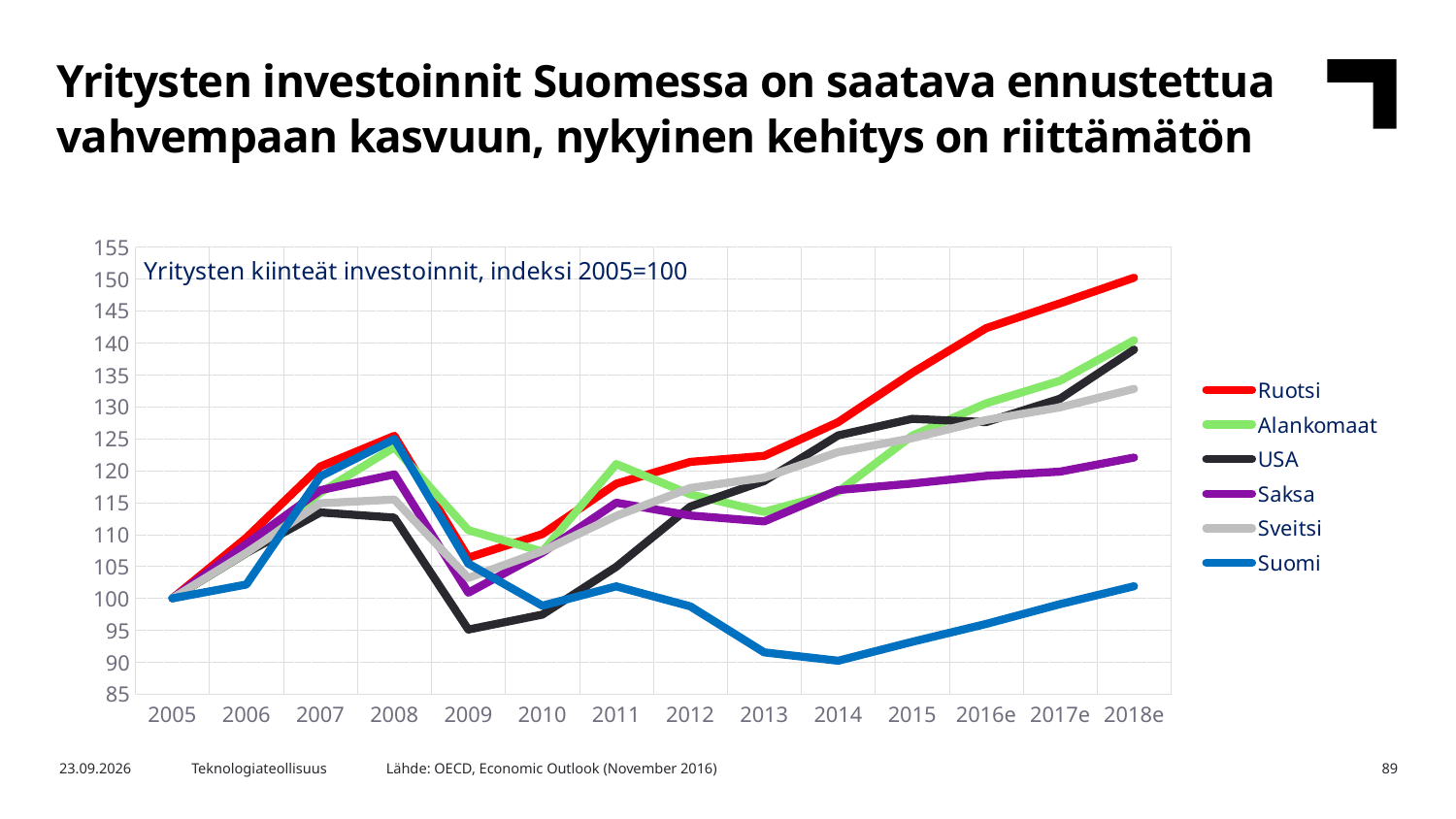
What is the title shown inside the chart area? Yritysten kiinteät investoinnit, indeksi 2005=100 Is the value for USA in 2009 greater or less than 100? less Is the value for Suomi in 2014 greater or less than 95? less Which country has the highest value in 2018e? Ruotsi What kind of chart is shown on the slide? line chart Does the Suomi line rise or fall from 2014 to 2018e? rise Which country has the lowest value in 2018e? Suomi How many years are shown on the x axis? 14 Is the value for Ruotsi in 2018e greater or less than 145? greater How many series does the legend list? 6 In 2013, which is larger: the value for Alankomaat or the value for Suomi? Alankomaat What is the index value for Ruotsi in 2005? 100